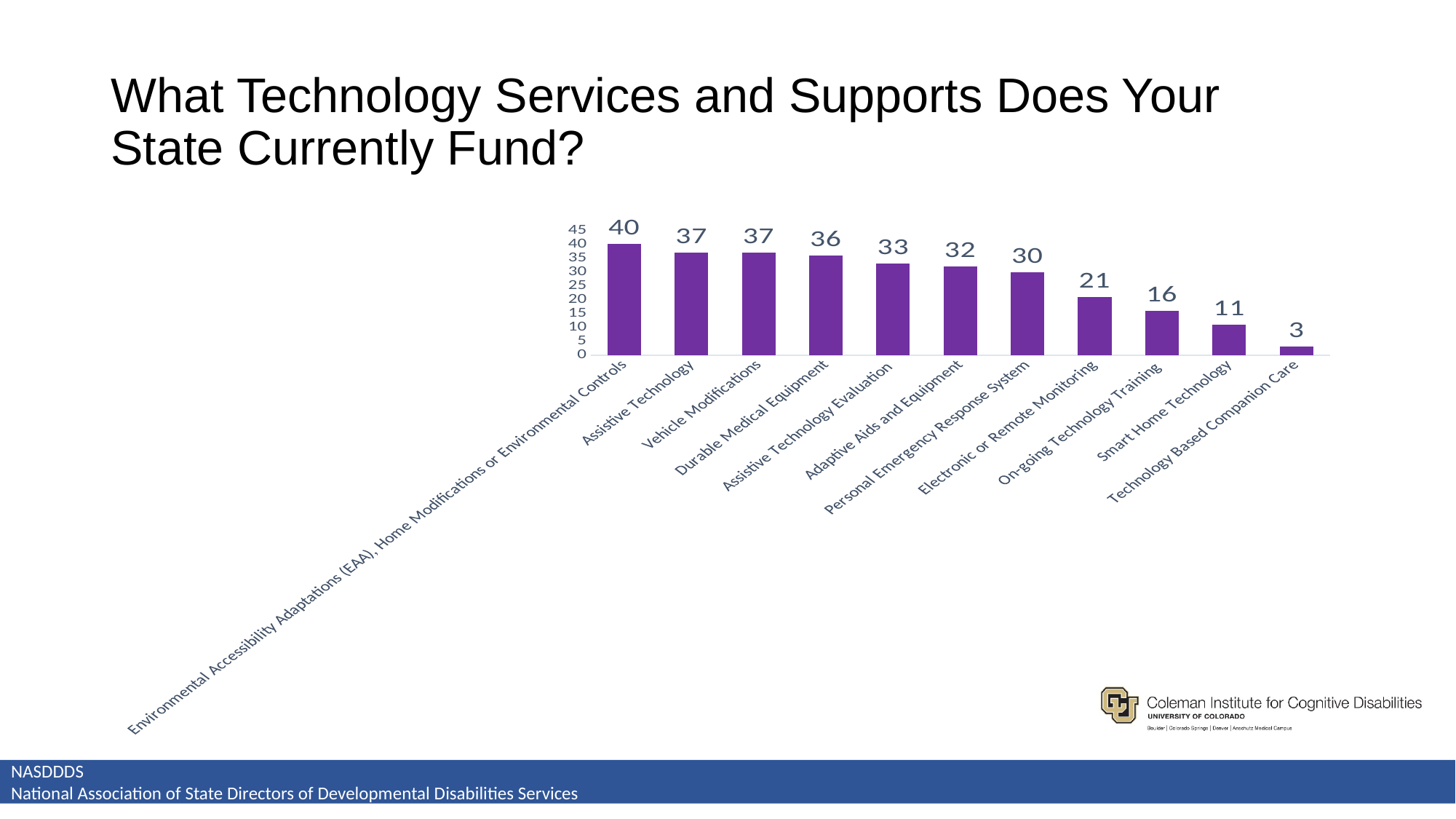
Which is larger, the value for Personal Emergency Response System or the value for Adaptive Aids and Equipment? Adaptive Aids and Equipment Do the values rise or fall from left to right along the x axis? fall Which category has the lowest value? Technology Based Companion Care Is the value for Assistive Technology Evaluation greater or less than 30? greater Which category has the highest value? Environmental Accessibility Adaptations (EAA), Home Modifications or Environmental Controls What is the value for Electronic or Remote Monitoring? 21 What is the value for Smart Home Technology? 11 How many categories are shown in the chart? 11 What is the value for Assistive Technology? 37 What colour are the bars in the chart? purple What is the difference between the values for Durable Medical Equipment and On-going Technology Training? 20 What kind of chart is shown on the slide? bar chart